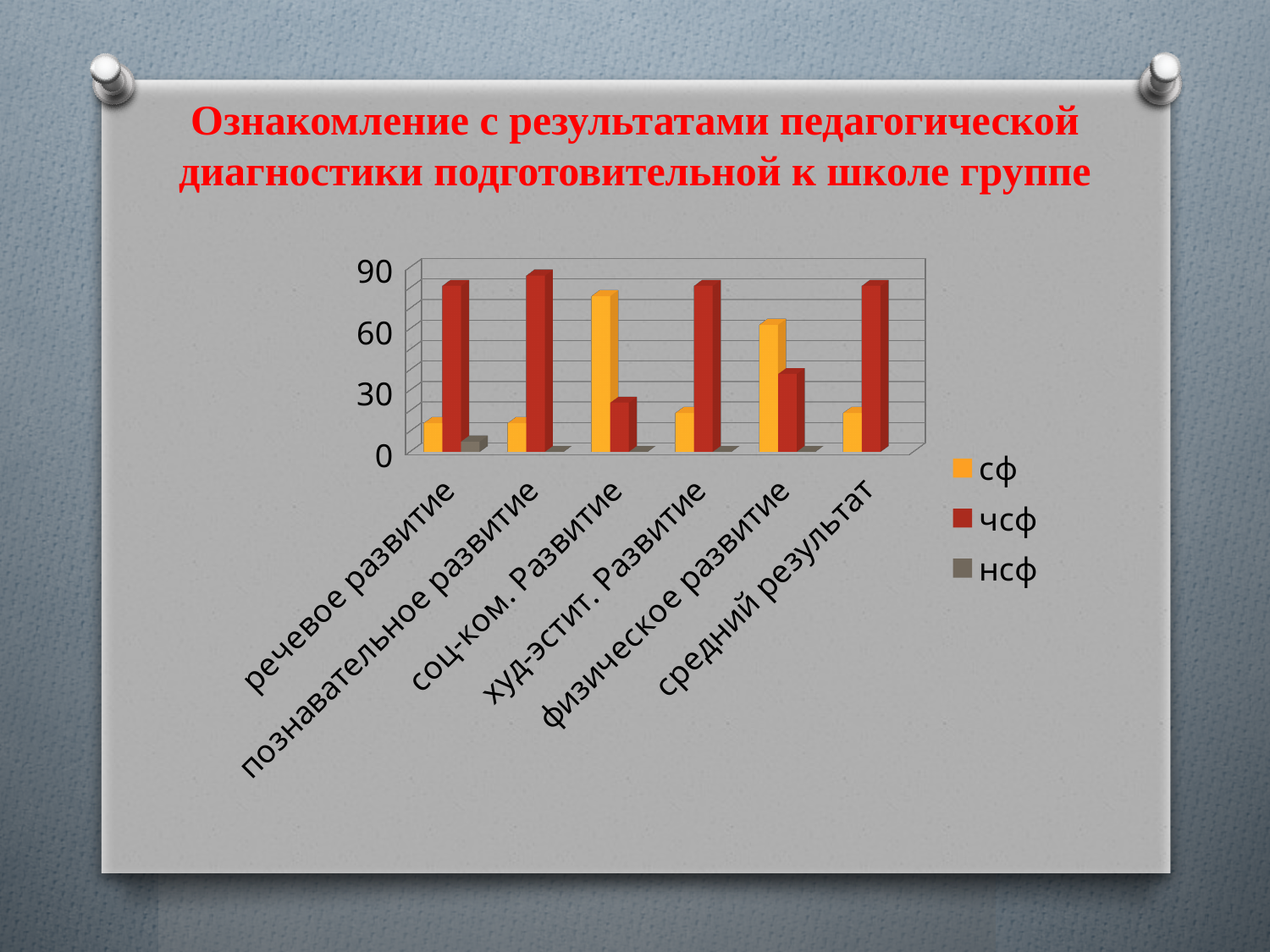
For физическое развитие, which series has the larger value, сф or чсф? сф What kind of chart is shown on the slide? bar chart Is the сф value for речевое развитие greater or less than 30? less Which category has the highest value for the сф series? соц-ком. развитие For средний результат, which series has the larger value, сф or чсф? чсф How many categories are shown along the x axis of the chart? 6 Is the чсф value for речевое развитие greater or less than 60? greater How many series does the chart legend list? 3 Which category has the lowest value for the чсф series? соц-ком. развитие Is the чсф value for физическое развитие greater or less than 30? greater What are the series names listed in the chart legend? сф, чсф, нсф